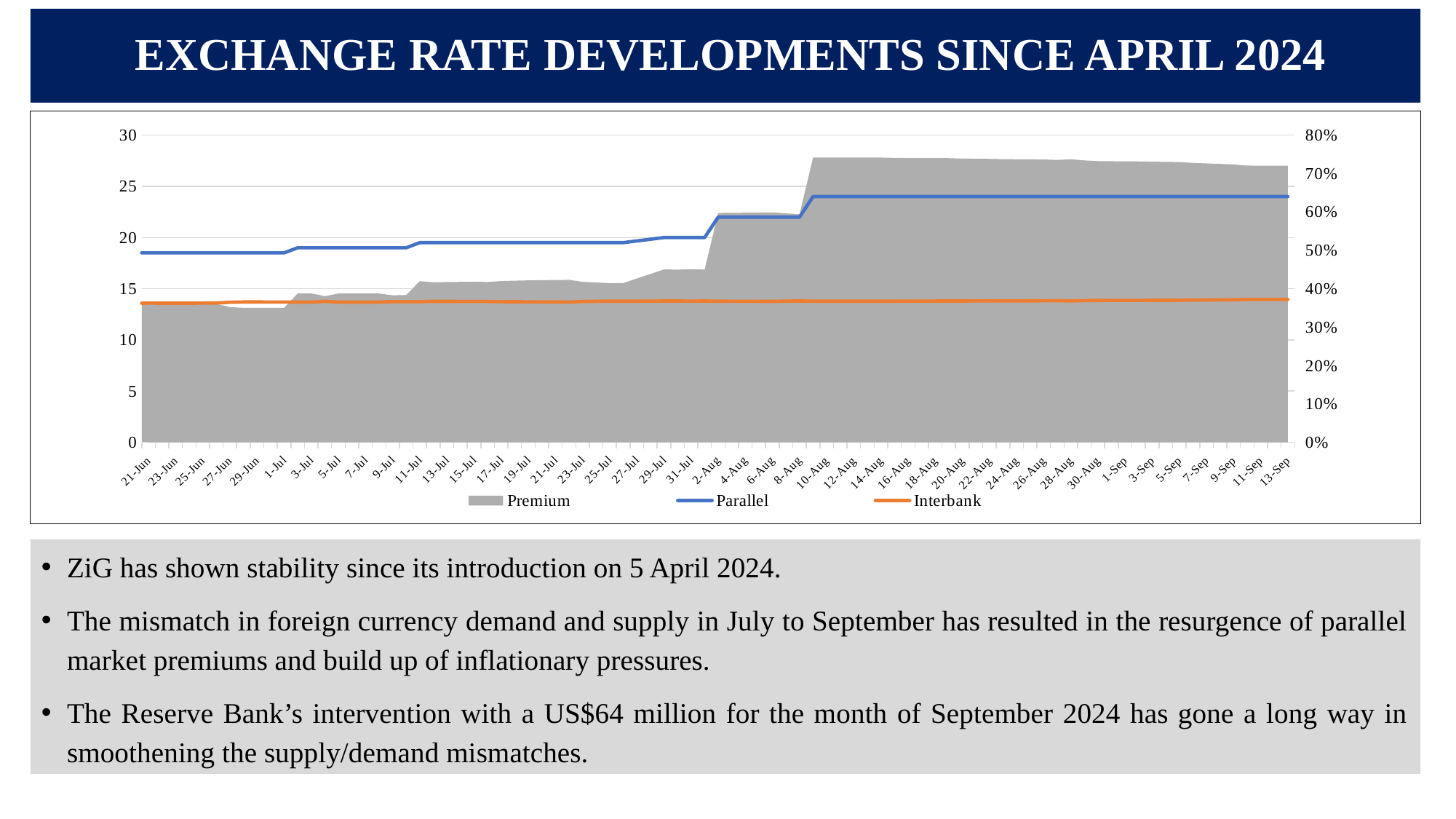
Is the Premium value on 13-Sep greater or less than 60%? greater Which series are listed in the chart legend? Premium, Parallel, Interbank On 13-Sep, which is higher, the Parallel rate or the Interbank rate? Parallel Is the Parallel value on 13-Sep greater or less than 20? greater Does the Parallel series rise or fall from 21-Jun to 13-Sep? Rise Does the Premium series overall rise or fall from 21-Jun to 13-Sep? Rise Is the Interbank value on 13-Sep greater or less than 15? less What is the title of the slide containing the chart? EXCHANGE RATE DEVELOPMENTS SINCE APRIL 2024 What kind of chart is shown on the slide? A combined area and line chart How many series does the chart legend list? 3